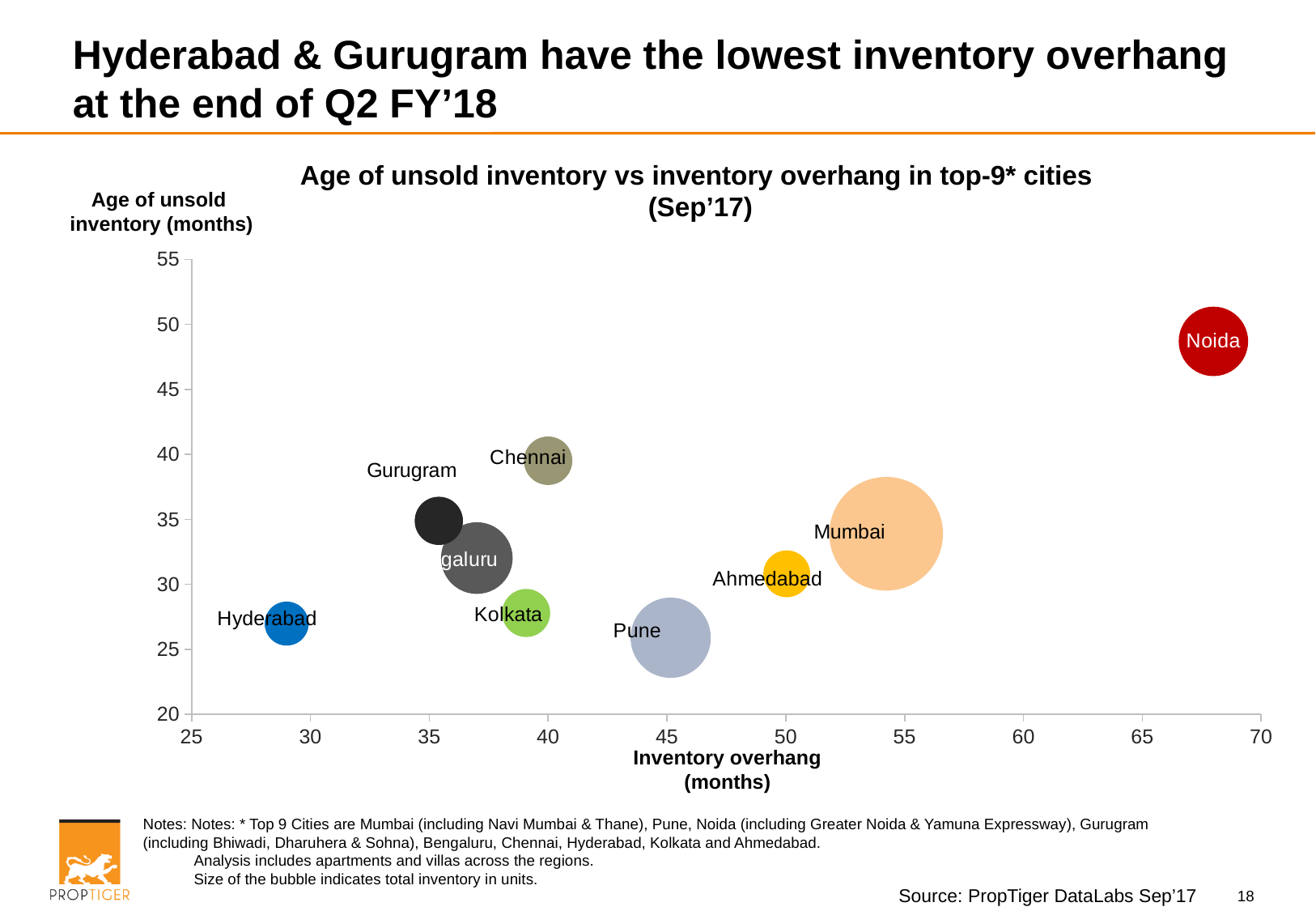
Is the inventory overhang for Noida greater or less than 65 months? greater Is the inventory overhang for Hyderabad greater or less than 30 months? less Which city has the highest inventory overhang? Noida Is the age of unsold inventory for Pune greater or less than 30 months? less Which city is represented by the largest bubble on the chart? Mumbai What kind of chart is shown on the slide? Bubble chart How many cities are plotted on the chart? 9 Which city has the lowest inventory overhang? Hyderabad Which city has the highest age of unsold inventory? Noida Which city has a higher age of unsold inventory, Chennai or Kolkata? Chennai